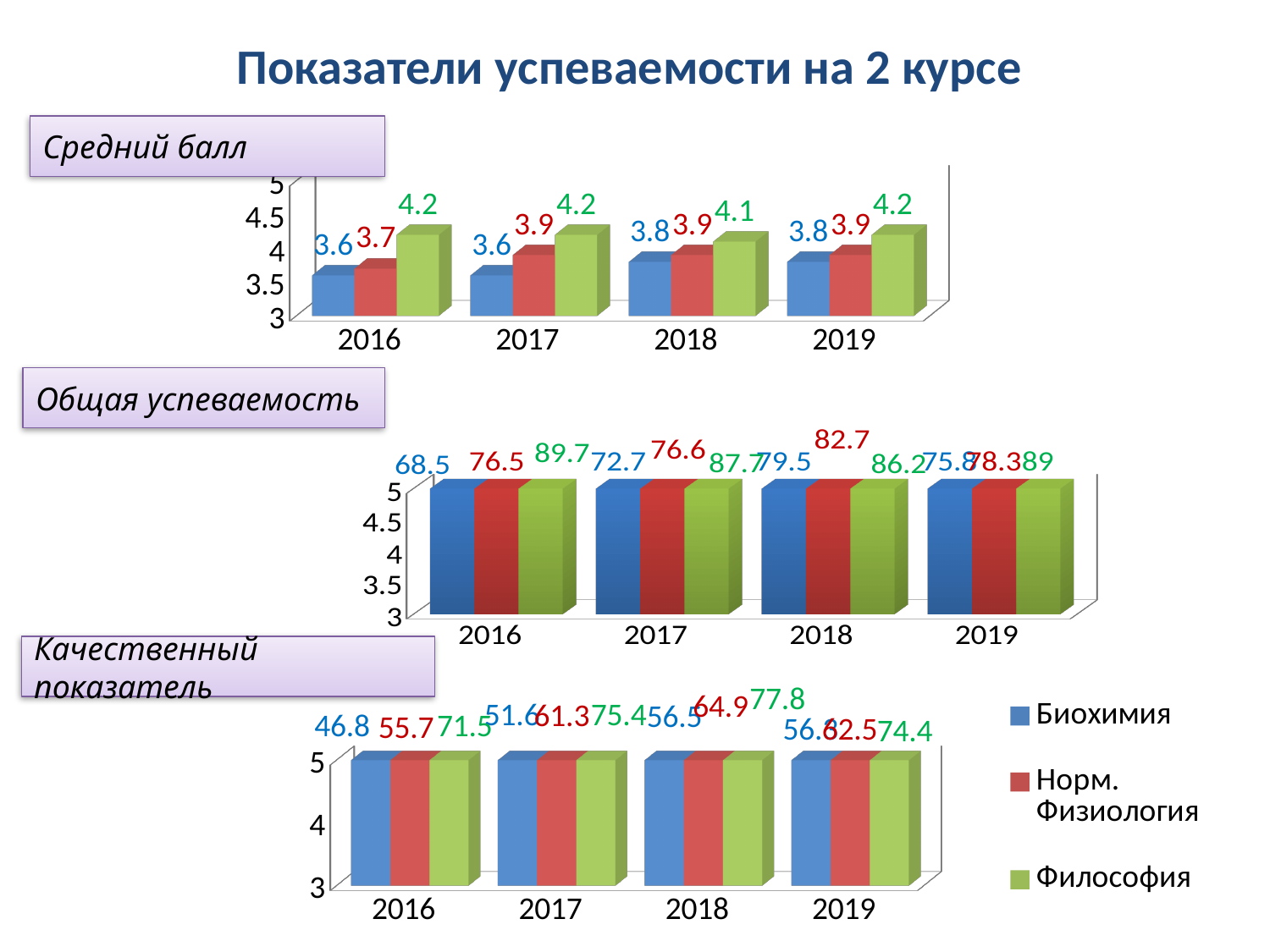
In the 'Общая успеваемость' chart, what is the value for Норм. Физиология in 2018? 82.7 How many series does the legend list on the slide? 3 In the 'Качественный показатель' chart, what is the value for Философия in 2018? 77.8 In the 'Средний балл' chart, which subject has the lowest value in 2017? Биохимия In the 'Общая успеваемость' chart, what is the value for Биохимия in 2016? 68.5 In the 'Средний балл' chart, what is the value for Биохимия in 2018? 3.8 In the 'Качественный показатель' chart, what is the difference between Норм. Физиология and Биохимия in 2016? 8.9 What type of chart is the 'Средний балл' chart? Bar chart In the 'Общая успеваемость' chart, which is larger in 2017: Биохимия or Норм. Физиология? Норм. Физиология In the 'Общая успеваемость' chart, which year has the highest value for Философия? 2016 In the 'Средний балл' chart, what is the value for Философия in 2016? 4.2 In the 'Средний балл' chart, what is the difference between Философия and Биохимия in 2016? 0.6